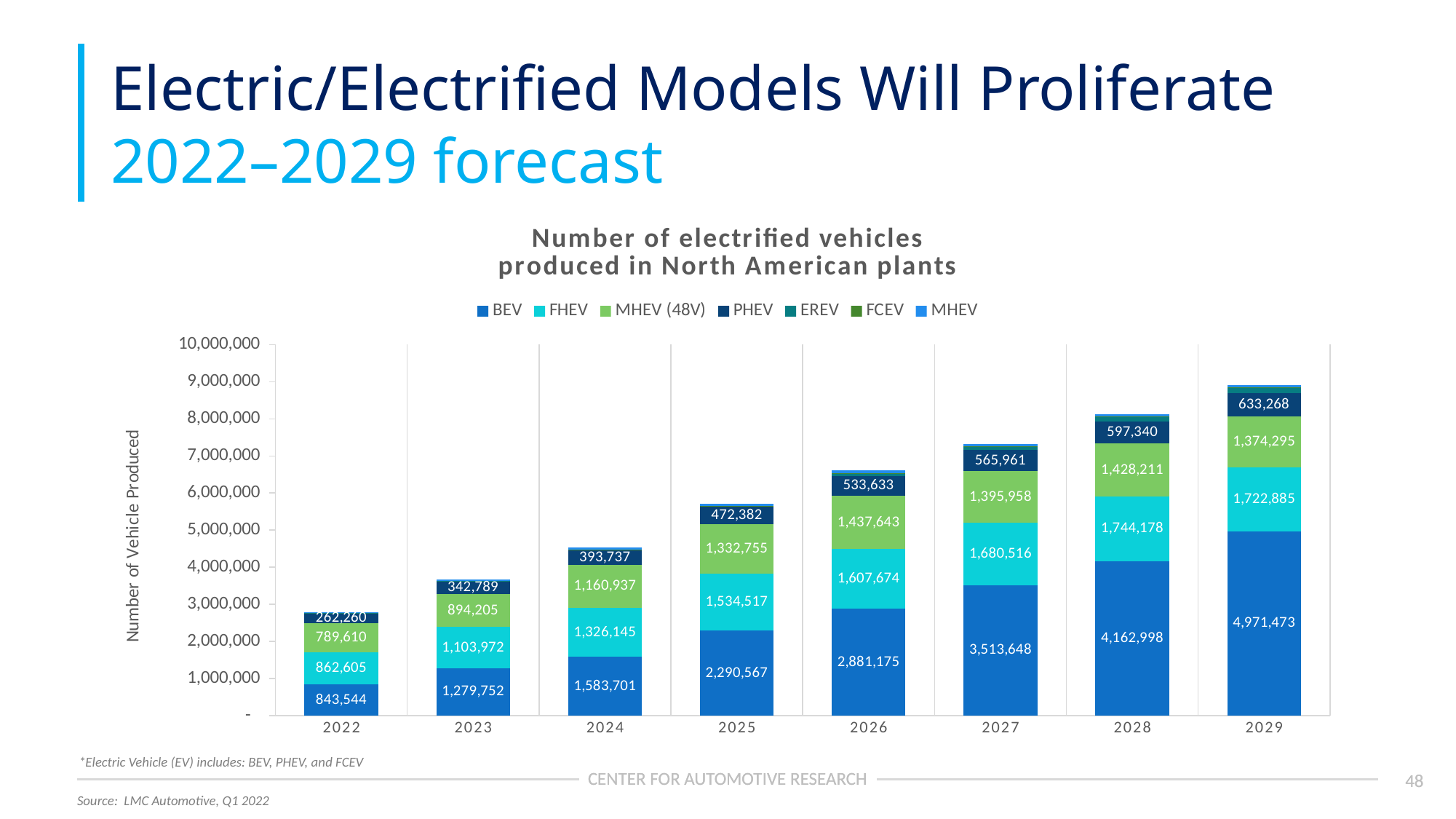
Which is larger, the FHEV value in 2028 or the FHEV value in 2029? 2028 Does the BEV value rise or fall from 2022 to 2029? rise What is the MHEV (48V) value for 2027? 1,395,958 What is the difference between the BEV value in 2029 and the BEV value in 2022? 4,127,929 In which year is the BEV value the highest? 2029 Is the total height of the 2029 stacked bar greater or less than 8,000,000? greater In which year is the BEV value the lowest? 2022 How many years are shown on the x axis? 8 What is the FHEV value for 2025? 1,534,517 What is the BEV value for 2022? 843,544 What is the PHEV value for 2029? 633,268 How many series does the legend list? 7